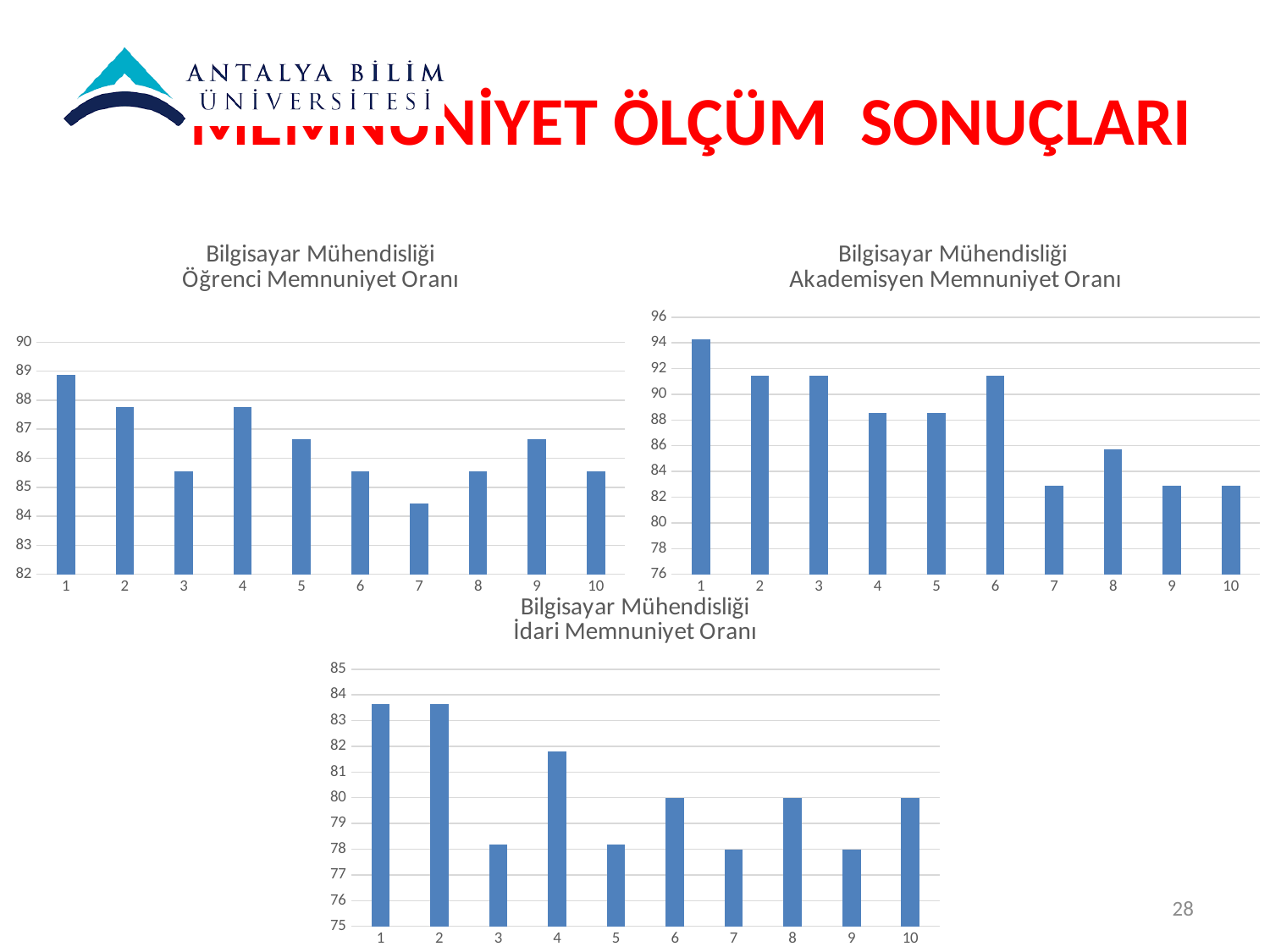
In the 'Bilgisayar Mühendisliği İdari Memnuniyet Oranı' chart, is the value for category 4 greater or less than 81? greater In the 'Bilgisayar Mühendisliği Öğrenci Memnuniyet Oranı' chart, is the value for category 7 greater or less than 85? less How many charts are shown on the slide? 3 In the 'Bilgisayar Mühendisliği Akademisyen Memnuniyet Oranı' chart, which category has the highest value? 1 In the 'Bilgisayar Mühendisliği Akademisyen Memnuniyet Oranı' chart, which is larger, the value for category 2 or the value for category 4? category 2 In the 'Bilgisayar Mühendisliği Öğrenci Memnuniyet Oranı' chart, which category has the lowest value? 7 In the 'Bilgisayar Mühendisliği Akademisyen Memnuniyet Oranı' chart, is the value for category 7 greater or less than 84? less In the 'Bilgisayar Mühendisliği İdari Memnuniyet Oranı' chart, which is larger, the value for category 1 or the value for category 3? category 1 What kind of chart is the 'Bilgisayar Mühendisliği Öğrenci Memnuniyet Oranı' chart? bar chart In the 'Bilgisayar Mühendisliği Öğrenci Memnuniyet Oranı' chart, which category has the highest value? 1 How many categories are shown on the x axis of the 'Bilgisayar Mühendisliği Öğrenci Memnuniyet Oranı' chart? 10